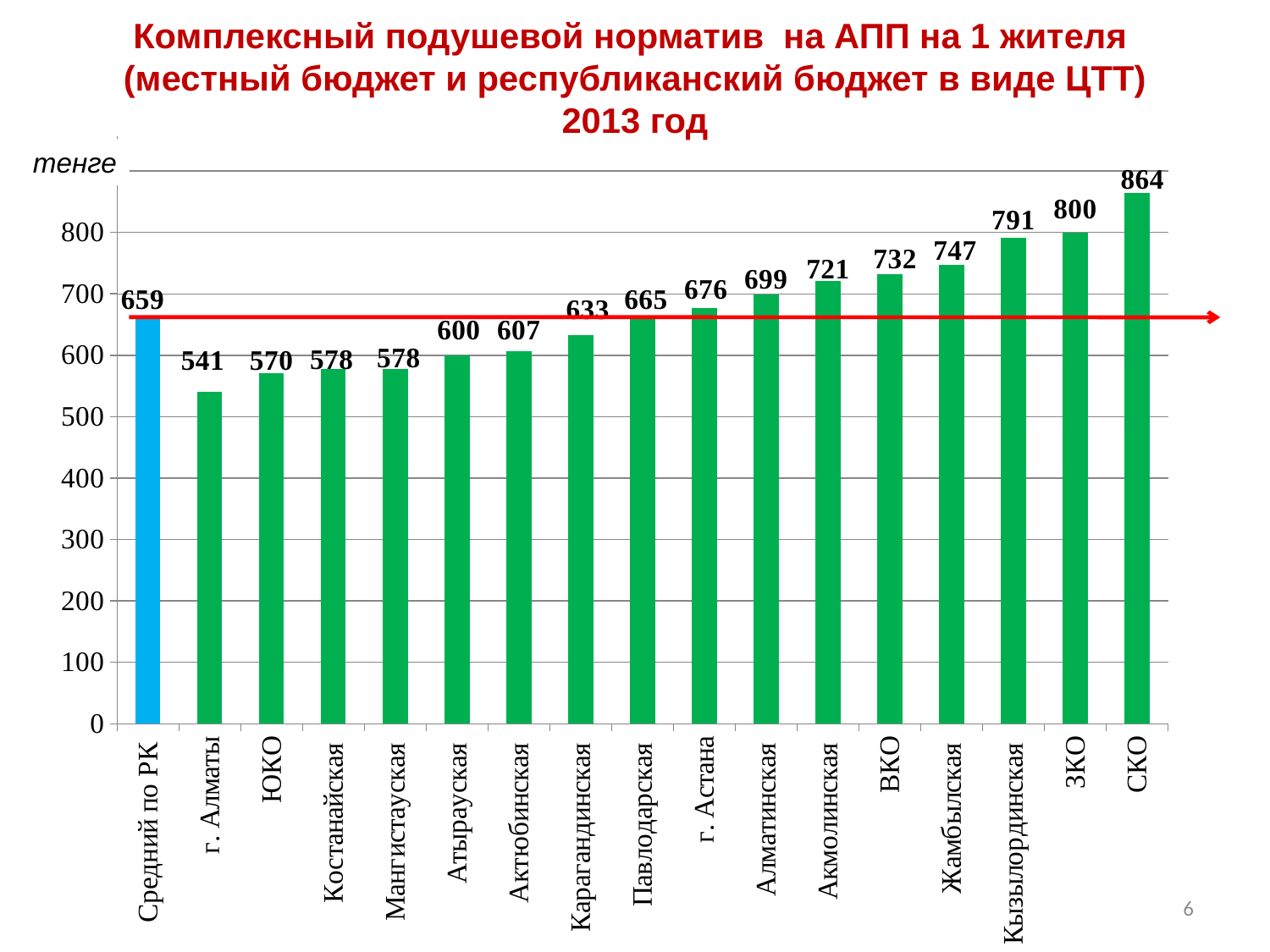
What is the difference between the values for СКО and г. Алматы? 323 What kind of chart is shown on the slide? bar chart Which category has the lowest value? г. Алматы Which category has the highest value? СКО Which is larger, the value for Павлодарская or the value for г. Астана? г. Астана What unit is indicated at the top of the vertical axis? тенге How many bars are shown in the chart? 17 What is the value for Кызылординская? 791 What is the difference between the values for ЗКО and Средний по РК? 141 What is the value for СКО? 864 What is the value for Средний по РК? 659 What is the value for г. Алматы? 541